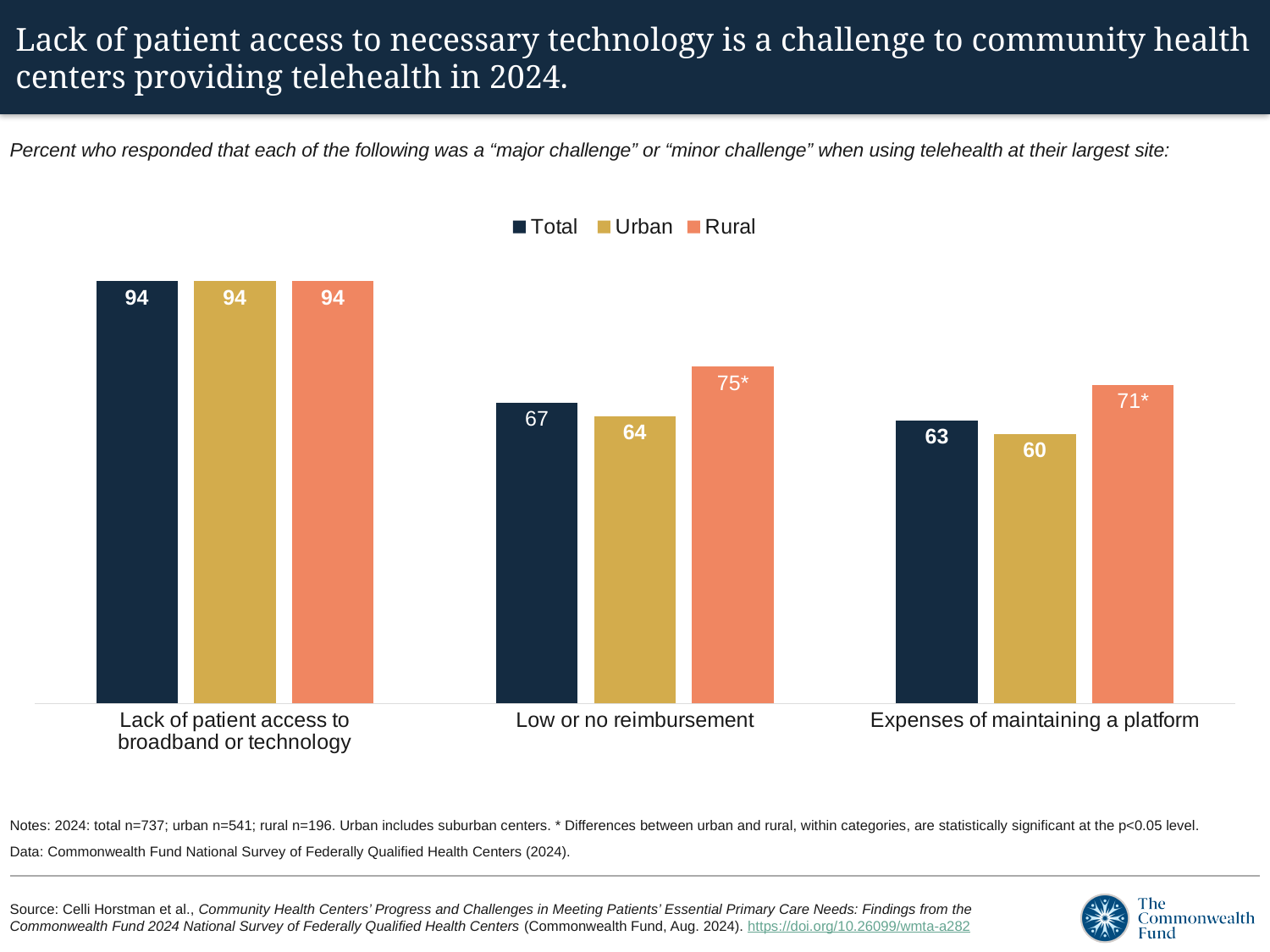
How many series does the legend list? 3 Which series is shown in orange in the legend? Rural What is the difference between the Rural and Urban values for "Low or no reimbursement"? 11 How many categories are shown on the x axis? 3 What kind of chart is shown on the slide? Bar chart What is the Total value for "Lack of patient access to broadband or technology"? 94 What is the Total value for "Expenses of maintaining a platform"? 63 What is the Rural value for "Expenses of maintaining a platform"? 71 For "Expenses of maintaining a platform", which is larger, the Rural value or the Total value? Rural Which category has the highest Total value? Lack of patient access to broadband or technology What is the Urban value for "Low or no reimbursement"? 64 Which category has the lowest Urban value? Expenses of maintaining a platform